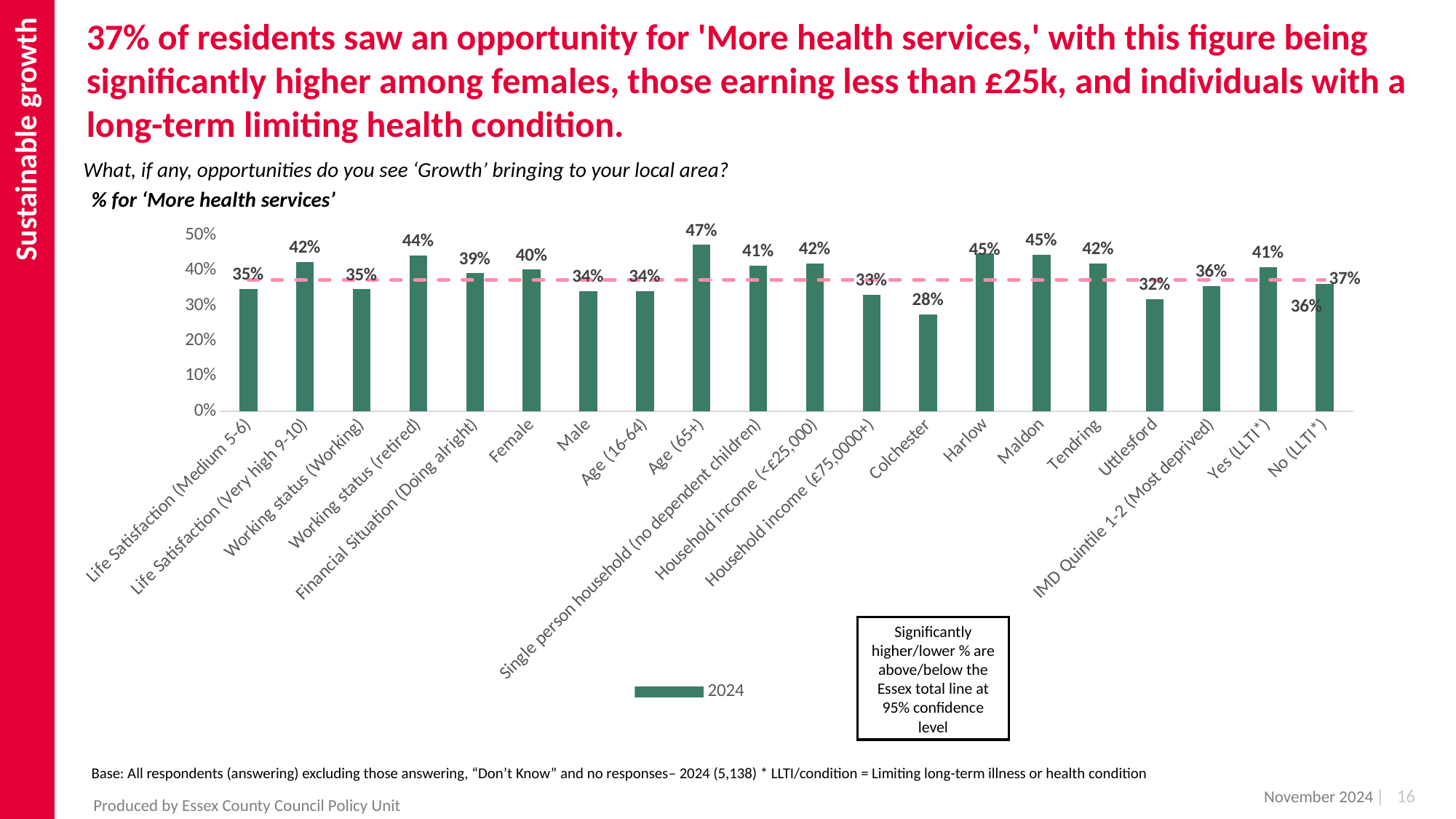
Which category has the highest value? Age (65+) What is the value for Colchester? 28% What kind of chart is shown on the slide? bar chart How many series does the legend list? 1 Is the value for Working status (retired) greater or less than 40%? greater Which is larger, the value for Harlow or the value for Uttlesford? Harlow What is the value for Female? 40% What is the difference between the values for Female and Male? 6% How many categories are shown on the x axis? 20 What is the value for Age (65+)? 47% Which category has the lowest value? Colchester What is the value for Household income (<£25,000)? 42%